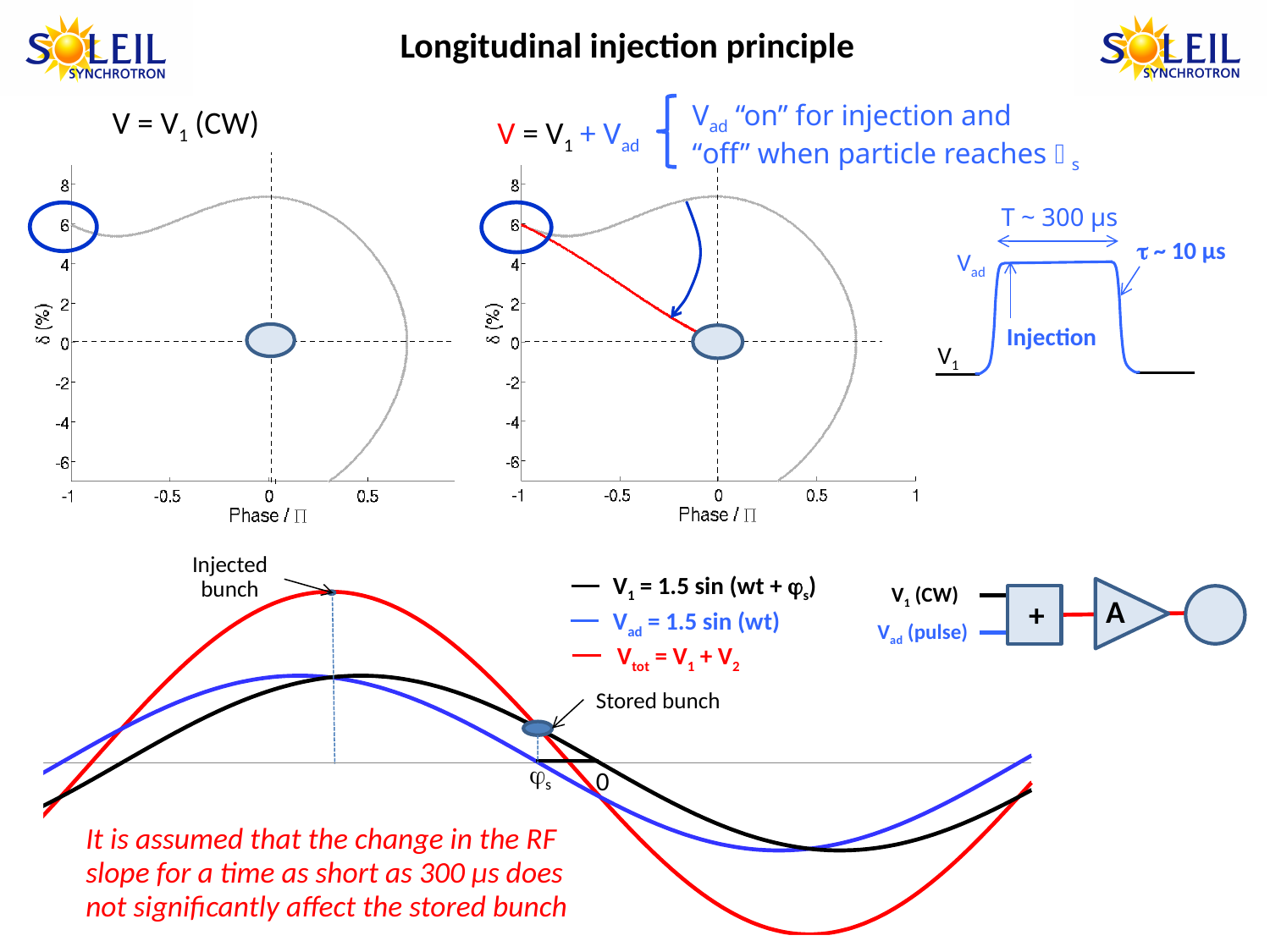
In the pulse diagram on the right, what rise time is labelled τ? ~ 10 µs In the bottom sine-wave chart, what amplitude is given for V_1 in the legend formula V_1 = 1.5 sin(wt + φs)? 1.5 What is the lowest y-axis tick value shown on the left phase-space plot? -6 What is the y-axis label of the two phase-space plots at the top of the slide? δ (%) What is the highest y-axis tick value shown on the left phase-space plot? 8 What is the x-axis label of the two phase-space plots at the top of the slide? Phase / π In the bottom sine-wave chart, which curve is the injected bunch placed on? The red V_tot curve In the bottom sine-wave chart, how many curves does the legend list? 3 In the pulse diagram on the right, what duration is labelled T? ~ 300 µs What kind of chart is the bottom plot showing V_1, V_ad and V_tot? Line chart In the bottom sine-wave chart, which curve has the largest amplitude: V_1, V_ad or V_tot? V_tot